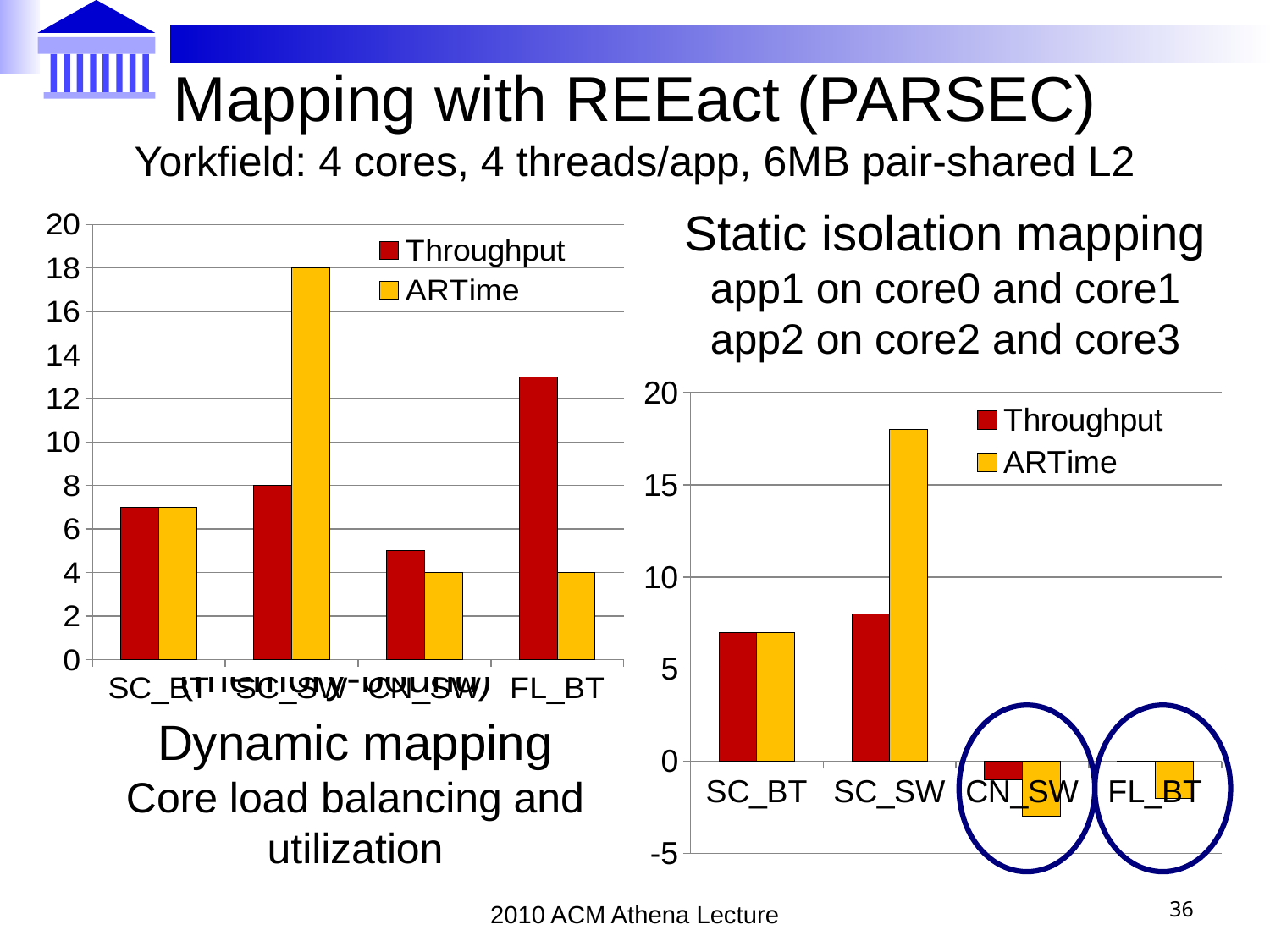
What type of chart is the left chart (Dynamic mapping)? bar chart In the right chart (Static isolation mapping), which is larger for SC_SW: Throughput or ARTime? ARTime In the left chart (Dynamic mapping), is the Throughput value for FL_BT greater or less than 12? greater How many categories are shown on the x axis of the left chart (Dynamic mapping)? 4 In the right chart (Static isolation mapping), is the ARTime value for SC_SW greater or less than 15? greater In the left chart (Dynamic mapping), which category has the highest ARTime bar? SC_SW In the left chart (Dynamic mapping), what is the ARTime value for FL_BT? 4 How many series does the legend of the right chart (Static isolation mapping) list? 2 In the left chart (Dynamic mapping), which category has the highest Throughput bar? FL_BT In the left chart (Dynamic mapping), what is the ARTime value for SC_SW? 18 In the left chart (Dynamic mapping), what is the Throughput value for SC_SW? 8 In the right chart (Static isolation mapping), is the ARTime value for CN_SW greater or less than 0? less